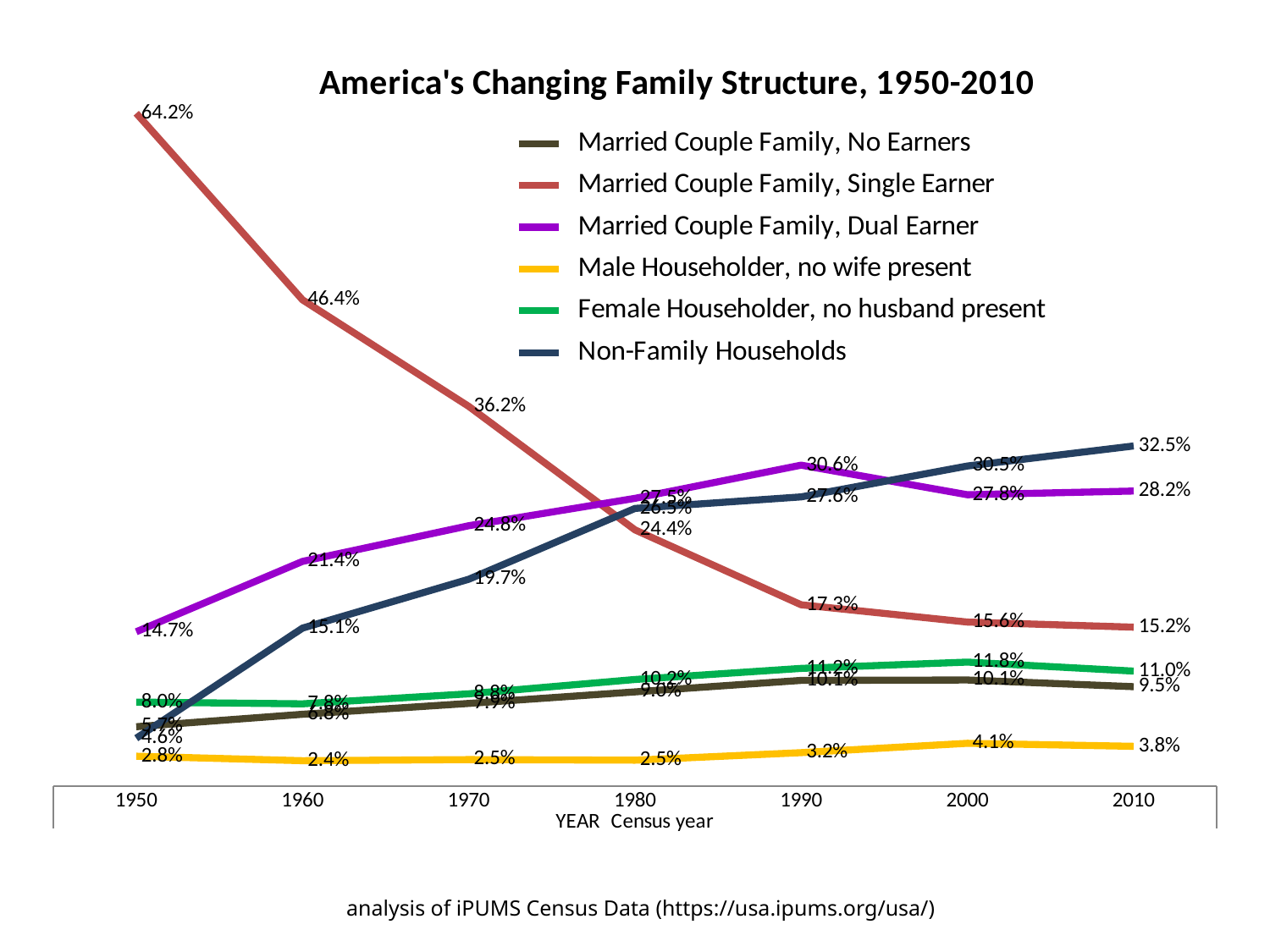
What type of chart is shown on the slide? Line chart In 2010, which is larger: Female Householder, no husband present or Married Couple Family, No Earners? Female Householder, no husband present How many series does the legend list? 6 What is the value for Married Couple Family, Single Earner in 1950? 64.2% How many census years are plotted along the x axis? 7 What is the value for Married Couple Family, Single Earner in 1980? 24.4% What is the difference between the Married Couple Family, Single Earner values in 1950 and 2010? 49.0% What is the value for Non-Family Households in 2010? 32.5% Does the Married Couple Family, Single Earner series rise or fall from 1950 to 2010? Fall What is the value for Male Householder, no wife present in 2000? 4.1% Which series has the highest value in 2010? Non-Family Households Which series has the lowest value in 1950? Male Householder, no wife present